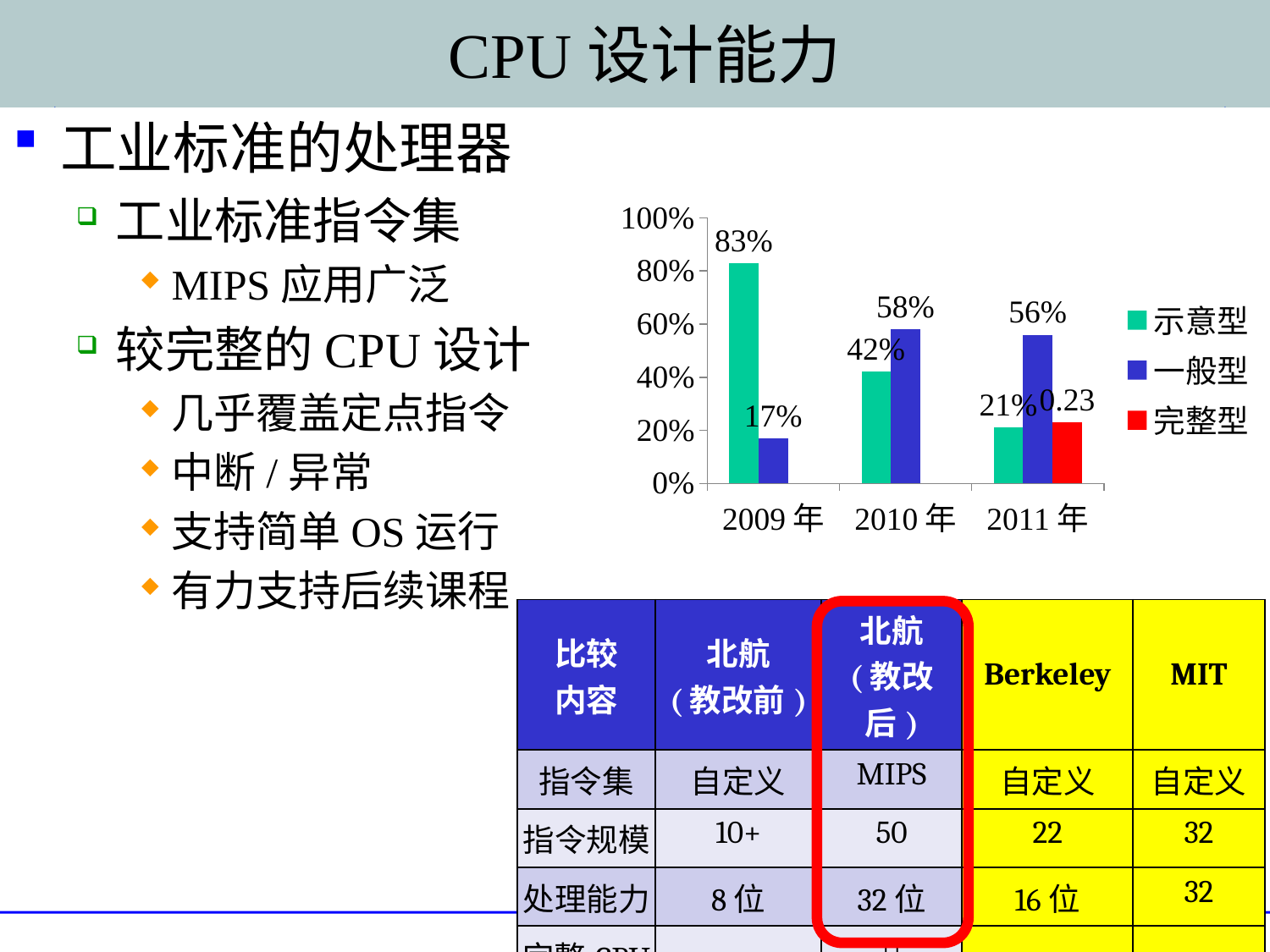
What is the value of 一般型 for 2010年? 58% How many year categories are shown on the x axis of the chart? 3 Does the 示意型 series rise or fall from 2009年 to 2011年? fall What is the difference between the 示意型 and 一般型 values for 2010年? 16% Which year has the highest value for 示意型? 2009年 What is the value of 示意型 for 2009年? 83% Which series in the legend is shown in red? 完整型 How many series does the chart legend list? 3 What is the value of 示意型 for 2011年? 21% What is the value of 一般型 for 2009年? 17% What kind of chart is shown on the slide? bar chart Which year has the lowest value for 一般型? 2009年